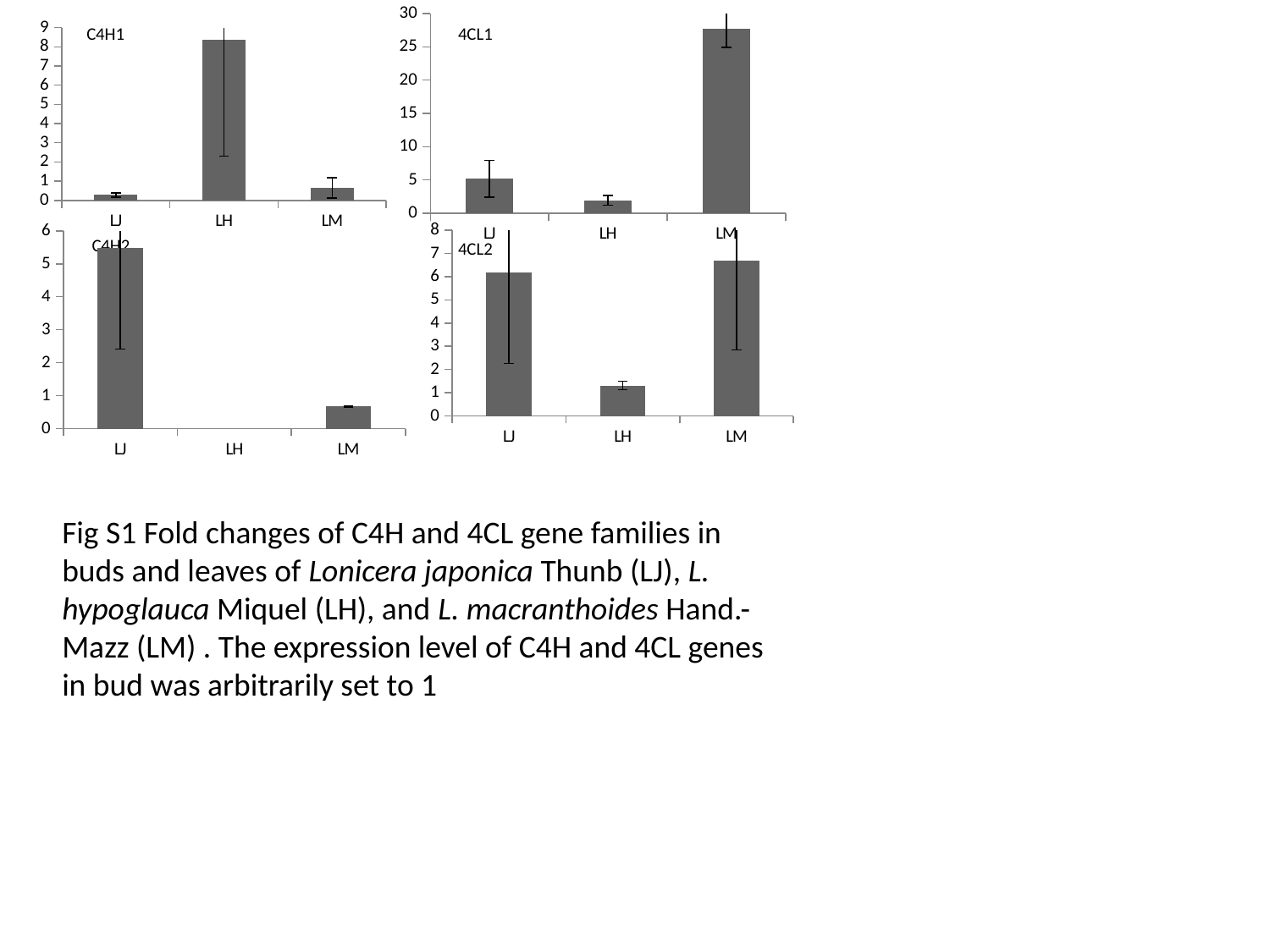
In the 4CL1 chart, which category has the highest value? LM In the 4CL1 chart, which category has the lowest value? LH In the C4H1 chart, which category has the highest value? LH In the C4H1 chart, is the value for LJ greater or less than 1? less How many categories are shown on the x axis of the 4CL2 chart? 3 In the C4H1 chart, is the value for LH greater or less than 5? greater What type of chart is the 4CL1 chart? bar chart In the 4CL2 chart, which category has the lowest value? LH In the 4CL1 chart, is the value for LM greater or less than 25? greater In the 4CL1 chart, which is larger, the value for LJ or the value for LH? LJ In the C4H2 chart, which category has the highest value? LJ